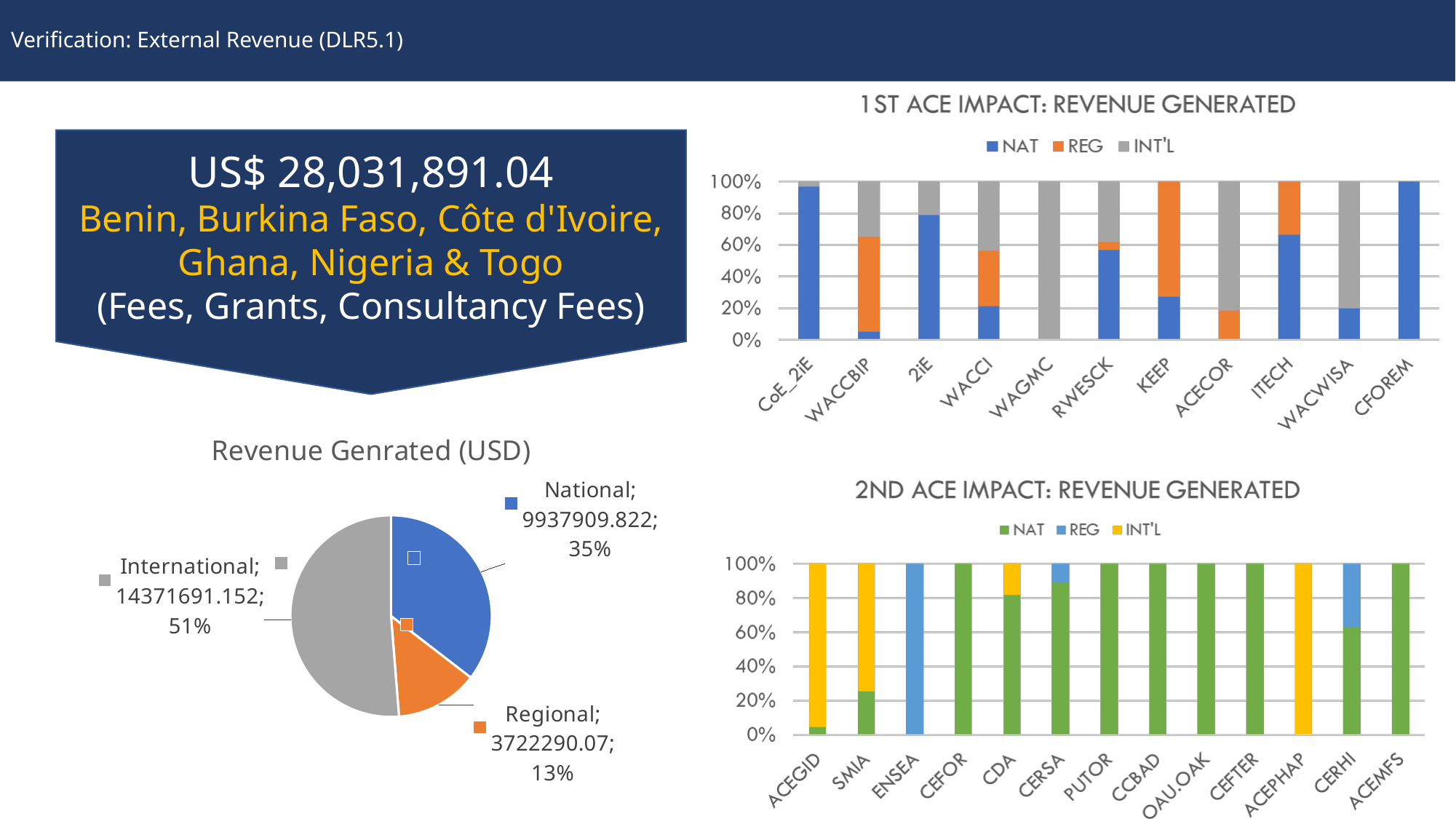
In the pie chart 'Revenue Genrated (USD)', how many slices are there? 3 In '1ST ACE IMPACT: REVENUE GENERATED', is the NAT value for 2iE greater or less than 60%? greater In the pie chart 'Revenue Genrated (USD)', what share of the pie is International? 51% How many series does the legend of '1ST ACE IMPACT: REVENUE GENERATED' list? 3 In the pie chart 'Revenue Genrated (USD)', what is the value for Regional? 3722290.07 In the pie chart 'Revenue Genrated (USD)', which category has the largest slice? International How many categories are shown on the x axis of '2ND ACE IMPACT: REVENUE GENERATED'? 13 In the pie chart 'Revenue Genrated (USD)', what is the value for National? 9937909.822 What kind of chart is '1ST ACE IMPACT: REVENUE GENERATED'? stacked bar chart In the pie chart 'Revenue Genrated (USD)', which category has the smallest slice? Regional How many categories are shown on the x axis of '1ST ACE IMPACT: REVENUE GENERATED'? 11 In '2ND ACE IMPACT: REVENUE GENERATED', is the NAT value for SMIA greater or less than 40%? less